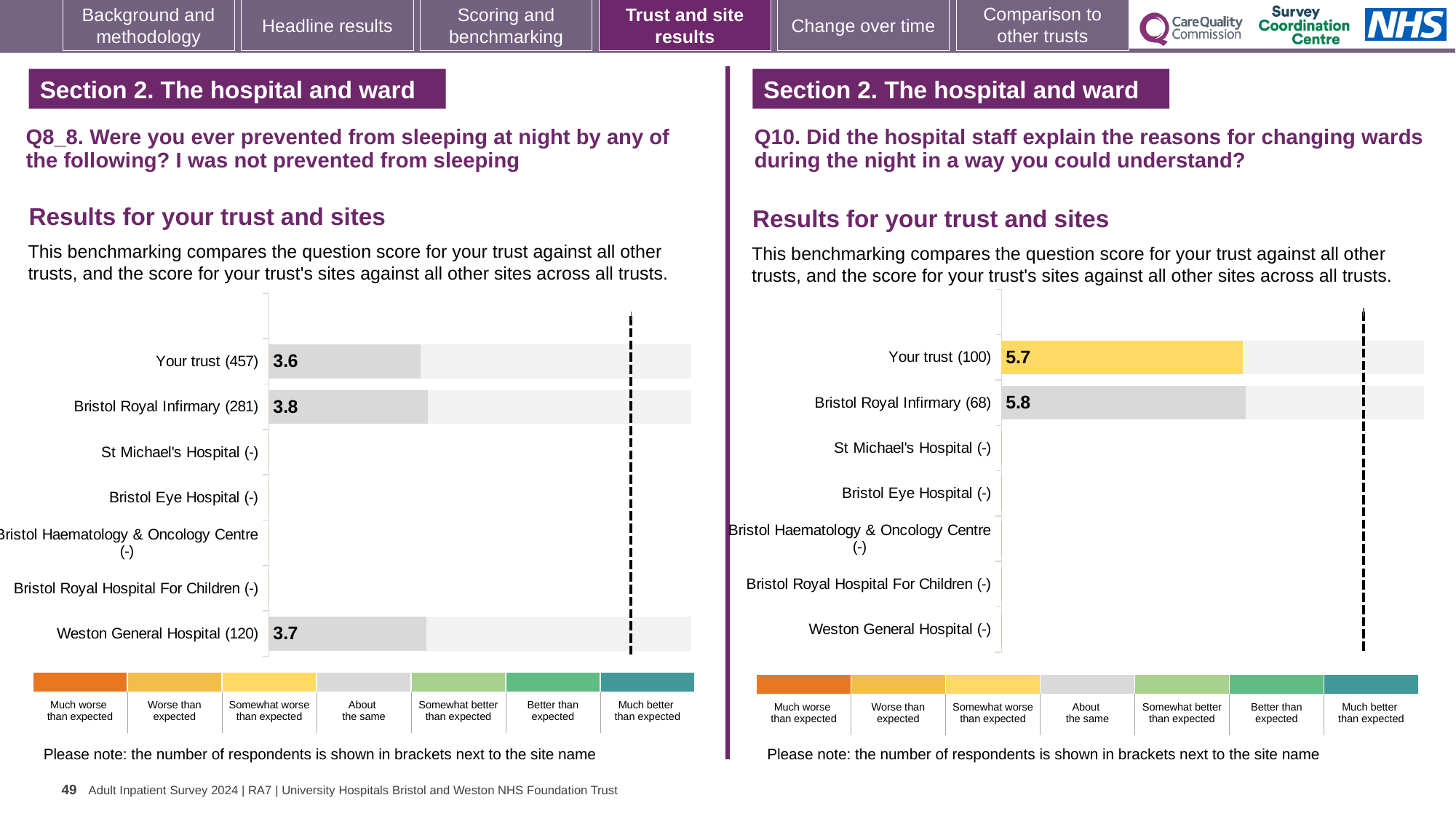
What kind of chart is used in the Q8_8 chart on the left? Bar chart In the Q8_8 chart on the left, which site or trust row has the highest score? Bristol Royal Infirmary How many site or trust rows are listed on the vertical axis of the Q10 chart on the right? 7 In the Q8_8 chart on the left, what is the score for Your trust? 3.6 In the Q10 chart on the right, what is the score for Your trust? 5.7 In the Q10 chart on the right, which is larger: the score for Your trust or for Bristol Royal Infirmary? Bristol Royal Infirmary In the Q8_8 chart on the left, what is the difference between the Bristol Royal Infirmary score and the Your trust score? 0.2 In the Q8_8 chart on the left, which row has the lowest score among those with a value shown? Your trust In the Q8_8 chart on the left, what is the score for Bristol Royal Infirmary? 3.8 In the Q10 chart on the right, how many respondents are shown in brackets for Your trust? 100 In the Q10 chart on the right, what is the score for Bristol Royal Infirmary? 5.8 In the Q8_8 chart on the left, what is the score for Weston General Hospital? 3.7